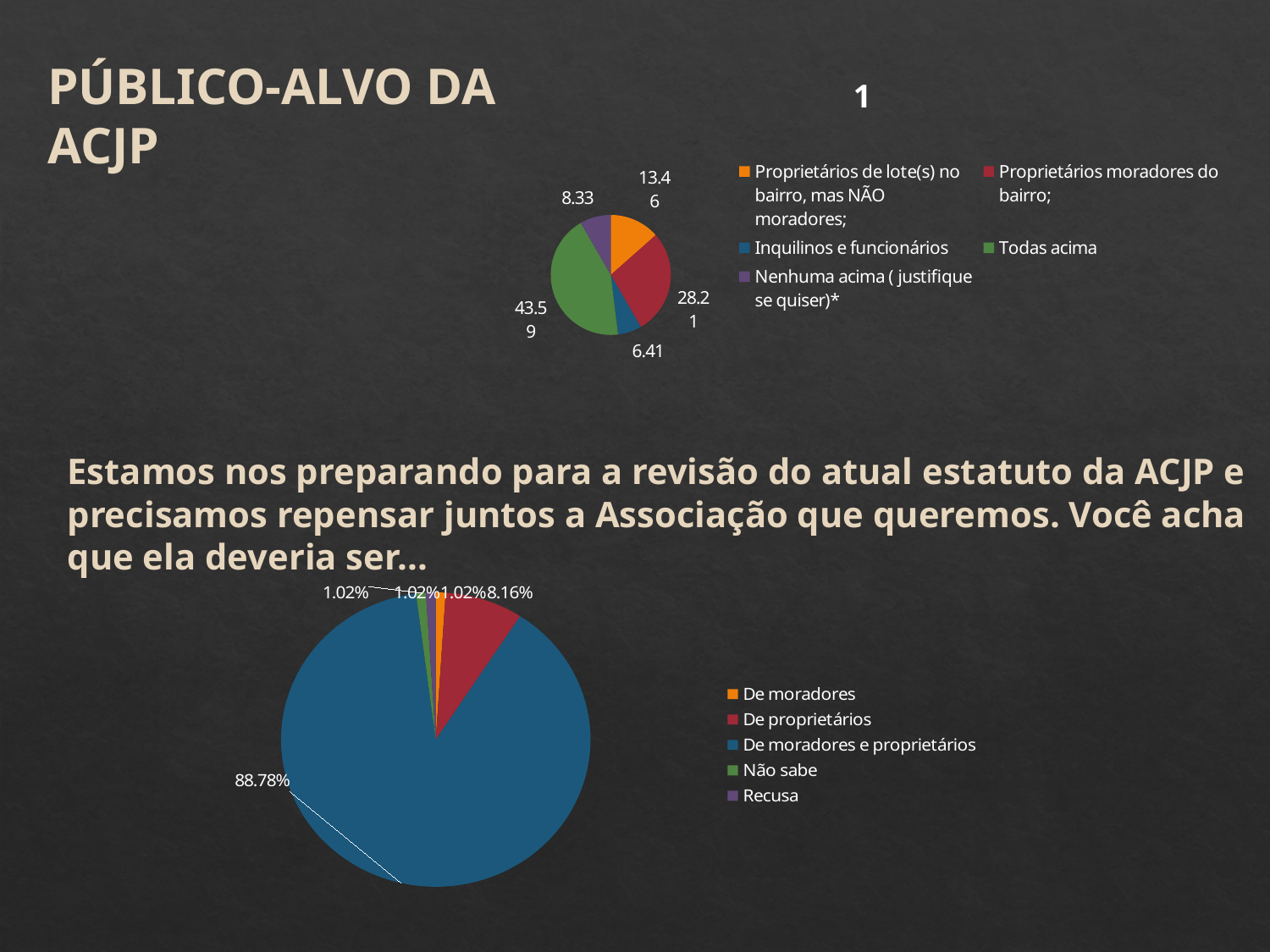
In the bottom pie chart, what is the difference between the shares for "De moradores e proprietários" and "De proprietários"? 80.62% In the top pie chart titled "1", what is the value for "Inquilinos e funcionários"? 6.41 In the top pie chart titled "1", which category has the largest slice? Todas acima In the top pie chart titled "1", what is the value for "Proprietários moradores do bairro"? 28.21 In the bottom pie chart, what is the share for "Recusa"? 1.02% In the bottom pie chart, what is the share for "De moradores e proprietários"? 88.78% In the bottom pie chart, what is the share for "De proprietários"? 8.16% In the top pie chart titled "1", which category has the smallest slice? Inquilinos e funcionários In the top pie chart titled "1", which is larger: "Proprietários de lote(s) no bairro, mas NÃO moradores" or "Nenhuma acima"? Proprietários de lote(s) no bairro, mas NÃO moradores In the top pie chart titled "1", how many categories does the legend list? 5 In the top pie chart titled "1", what is the value for "Todas acima"? 43.59 What type of chart is the bottom chart on the slide? Pie chart